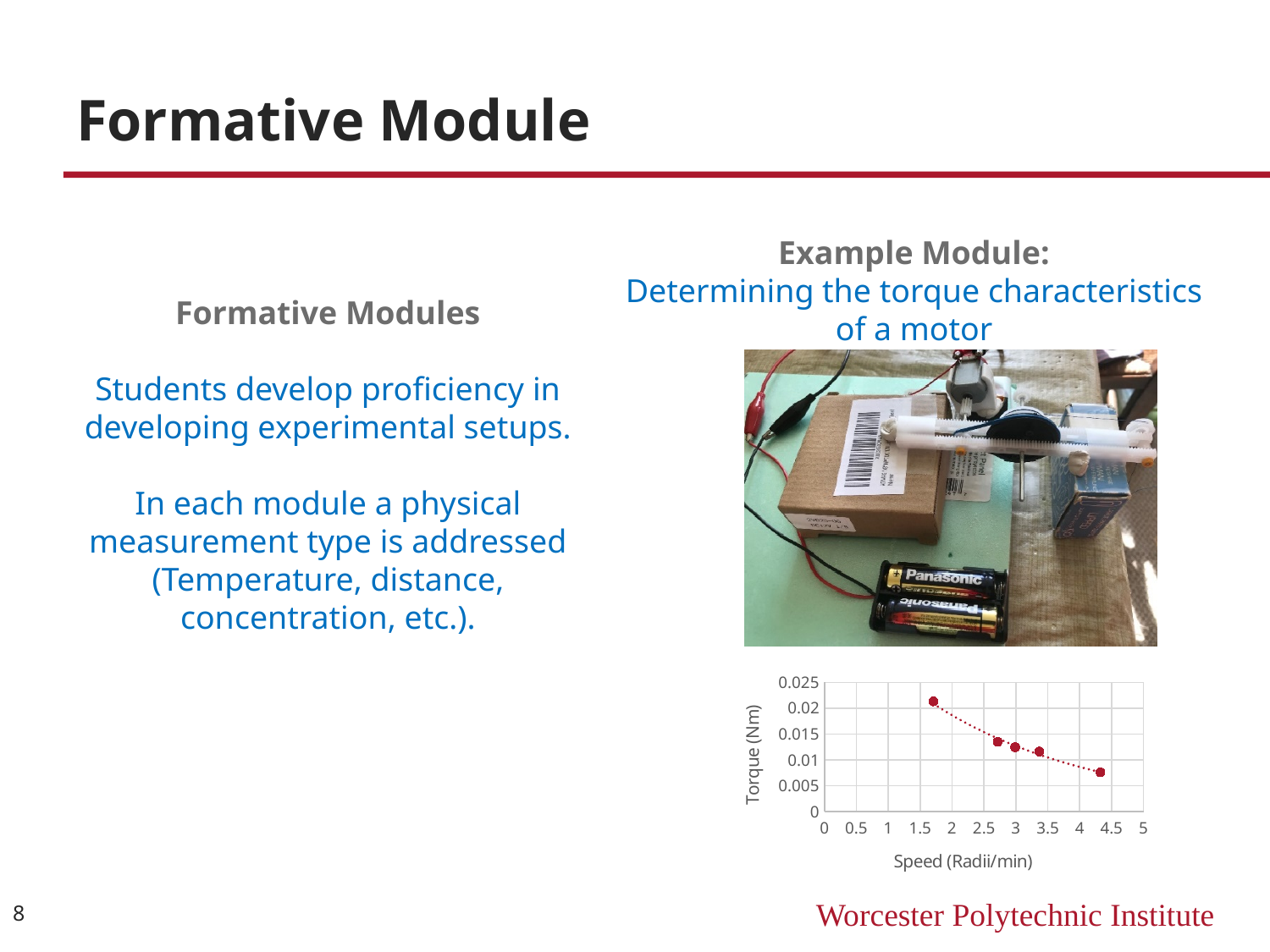
On the torque chart, is the torque of the rightmost point greater or less than 0.005? greater On the torque chart, is the torque of the leftmost point greater or less than 0.02? greater On the torque chart, how many data points have a torque above 0.01? 4 How many data points are plotted on the torque chart? 5 What is the label of the x axis on the torque chart? Speed (Radii/min) What kind of chart is shown at the bottom right of the slide? scatter chart On the torque chart, does torque rise or fall as speed increases? fall On the torque chart, is the speed of the leftmost point greater or less than 2? less What is the label of the y axis on the torque chart? Torque (Nm) On the torque chart, which has the larger torque: the leftmost point or the rightmost point? the leftmost point